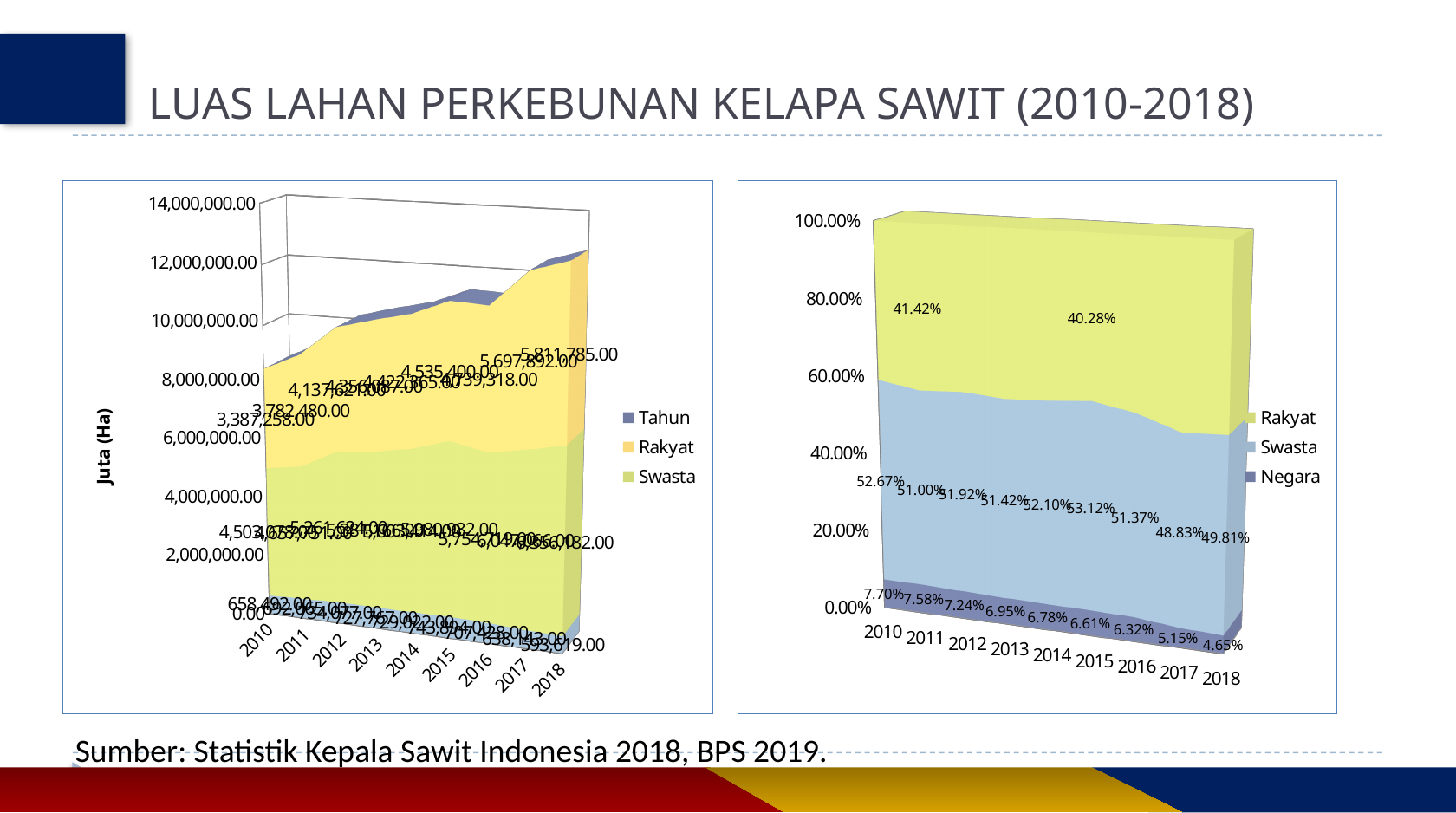
In the right-hand chart, does the Negara share rise or fall from 2010 to 2018? fall How many years are shown on the x axis of the right-hand chart? 9 In the right-hand chart, which year has the larger Swasta share, 2017 or 2018? 2018 In the right-hand chart, what is the value for Negara in 2018? 4.65% In the right-hand chart, what is the difference between the Negara share in 2010 and in 2018? 3.05% In the right-hand chart, what is the value for Swasta in 2015? 53.12% What kind of chart is the right-hand chart on the slide? area chart In the right-hand chart, how many series does the legend list? 3 What is the y-axis title of the left-hand chart? Juta (Ha) In the right-hand chart, in which year is the Negara share lowest? 2018 In the right-hand chart, in which year is the Negara share highest? 2010 In the right-hand chart, what is the value for Negara in 2010? 7.70%